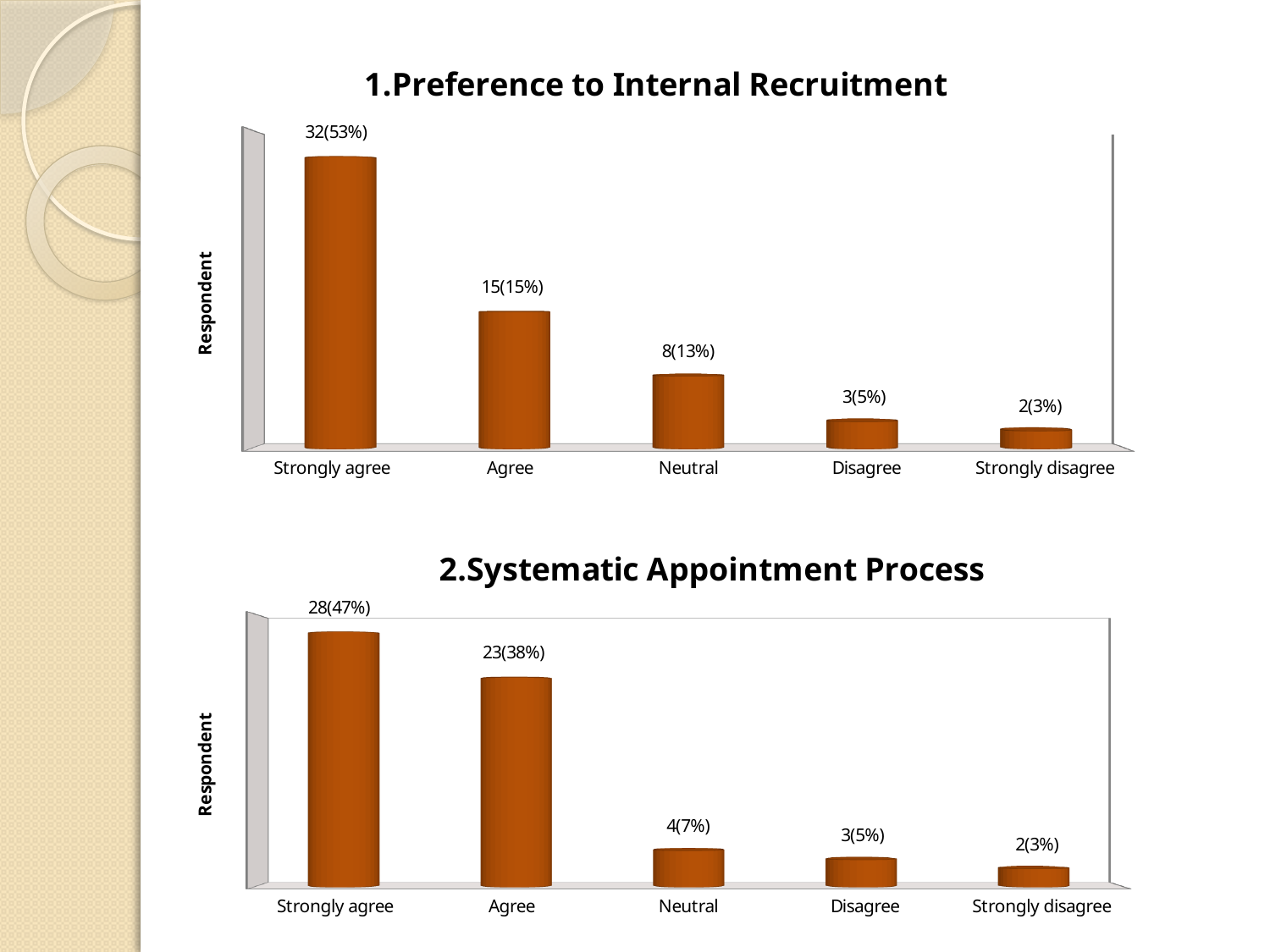
In the chart titled "1.Preference to Internal Recruitment", do the values rise or fall from Strongly agree to Strongly disagree? Fall In the chart titled "2.Systematic Appointment Process", what is the data label for Neutral? 4(7%) How many categories are shown on the x axis of the chart titled "1.Preference to Internal Recruitment"? 5 In the chart titled "1.Preference to Internal Recruitment", what is the data label for Strongly agree? 32(53%) In the chart titled "2.Systematic Appointment Process", what is the data label for Agree? 23(38%) In the chart titled "1.Preference to Internal Recruitment", which category has the highest number of respondents? Strongly agree In the chart titled "2.Systematic Appointment Process", how many more respondents chose Agree than Neutral? 19 In the chart titled "1.Preference to Internal Recruitment", how many more respondents chose Strongly agree than Agree? 17 In the chart titled "2.Systematic Appointment Process", which category has the lowest number of respondents? Strongly disagree In the chart titled "2.Systematic Appointment Process", which has more respondents, Agree or Disagree? Agree What kind of chart is the chart titled "2.Systematic Appointment Process"? Bar chart In the chart titled "1.Preference to Internal Recruitment", what is the data label for Neutral? 8(13%)